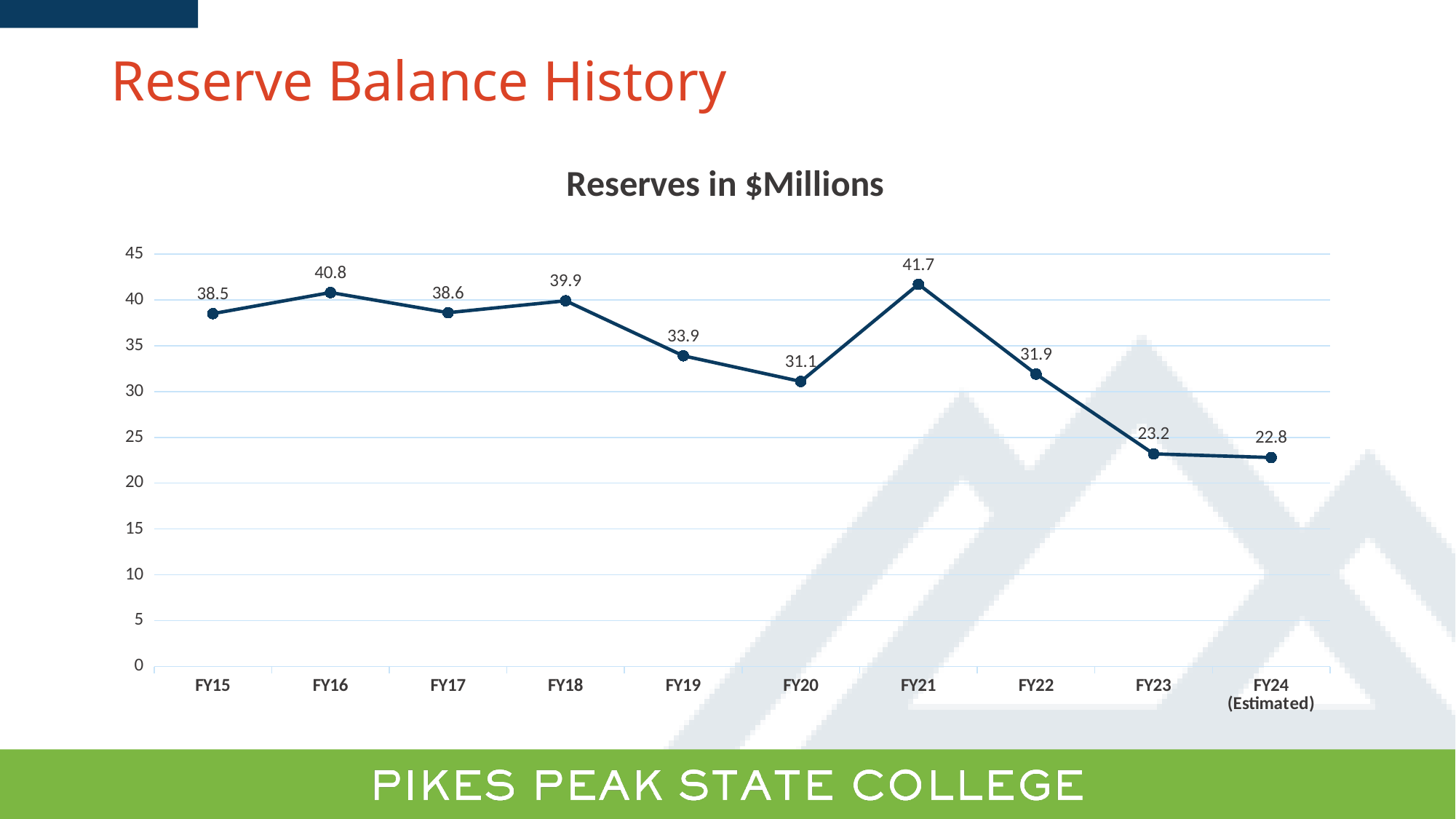
Is the reserve balance for FY19 greater or less than 30? greater Do the reserve balances rise or fall from FY21 to FY24? fall What is the estimated reserve balance for FY24? 22.8 What is the reserve balance for FY18? 39.9 Which fiscal year has the highest reserve balance? FY21 Which is larger, the reserve balance in FY16 or FY17? FY16 What is the title of the chart? Reserves in $Millions What is the difference between the reserve balance in FY21 and FY22? 9.8 Which fiscal year has the lowest reserve balance? FY24 (Estimated) What kind of chart is shown on the slide? line chart What is the reserve balance for FY20? 31.1 How many fiscal years are plotted on the chart? 10